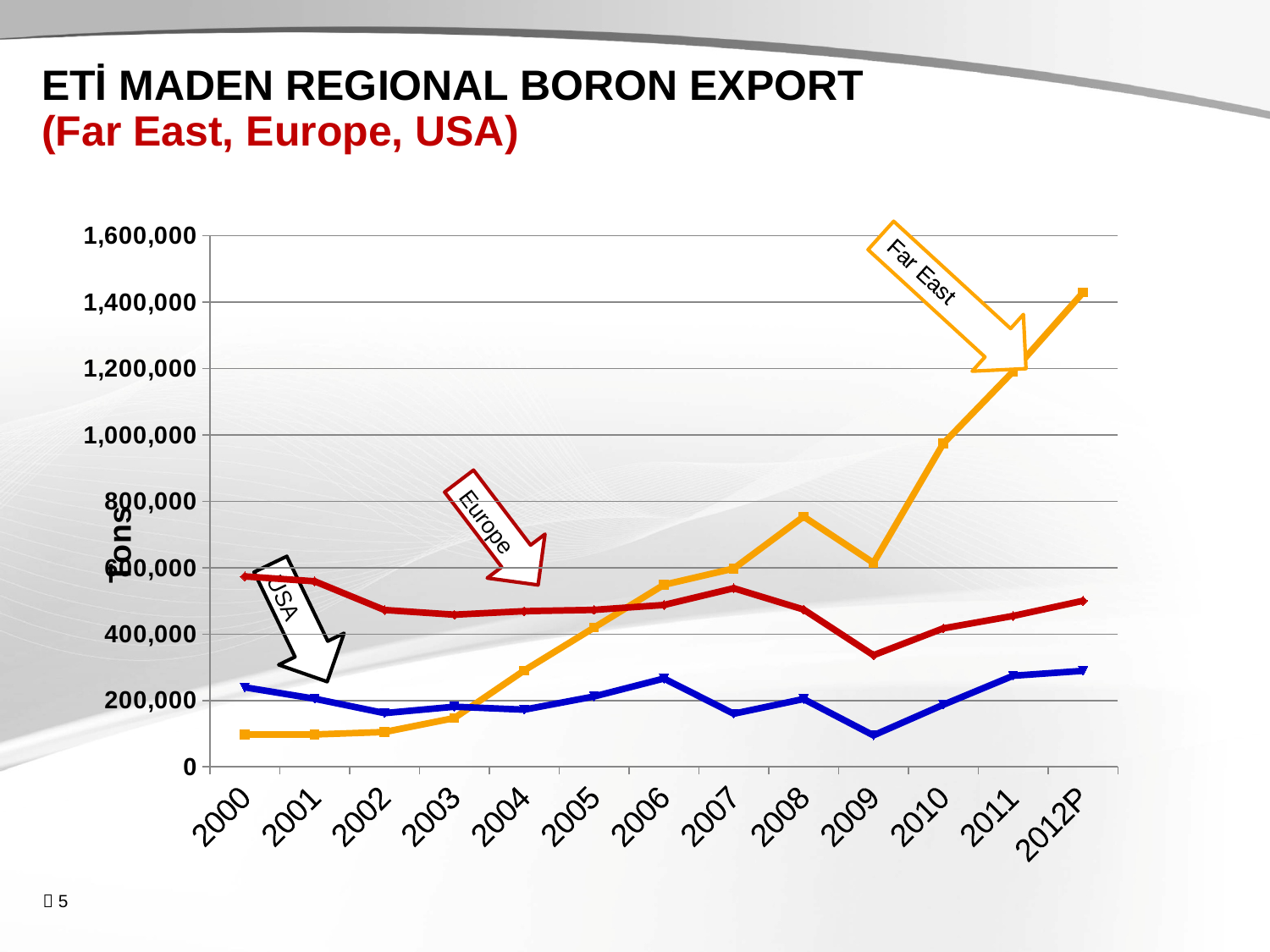
Which region has the highest export value in 2012P? Far East Is the USA value for 2009 greater or less than 200,000? less How many years (points) are shown along the x axis? 13 Is the Far East value for 2008 greater or less than 600,000? greater In which year is the Far East export value highest? 2012P In which year is the USA export value lowest? 2009 What is the label of the y axis? Tons How many series are plotted on the chart? 3 In which year is the Europe export value lowest? 2009 In 2000, which is larger: the Europe value or the Far East value? Europe What kind of chart is shown on the slide? line chart